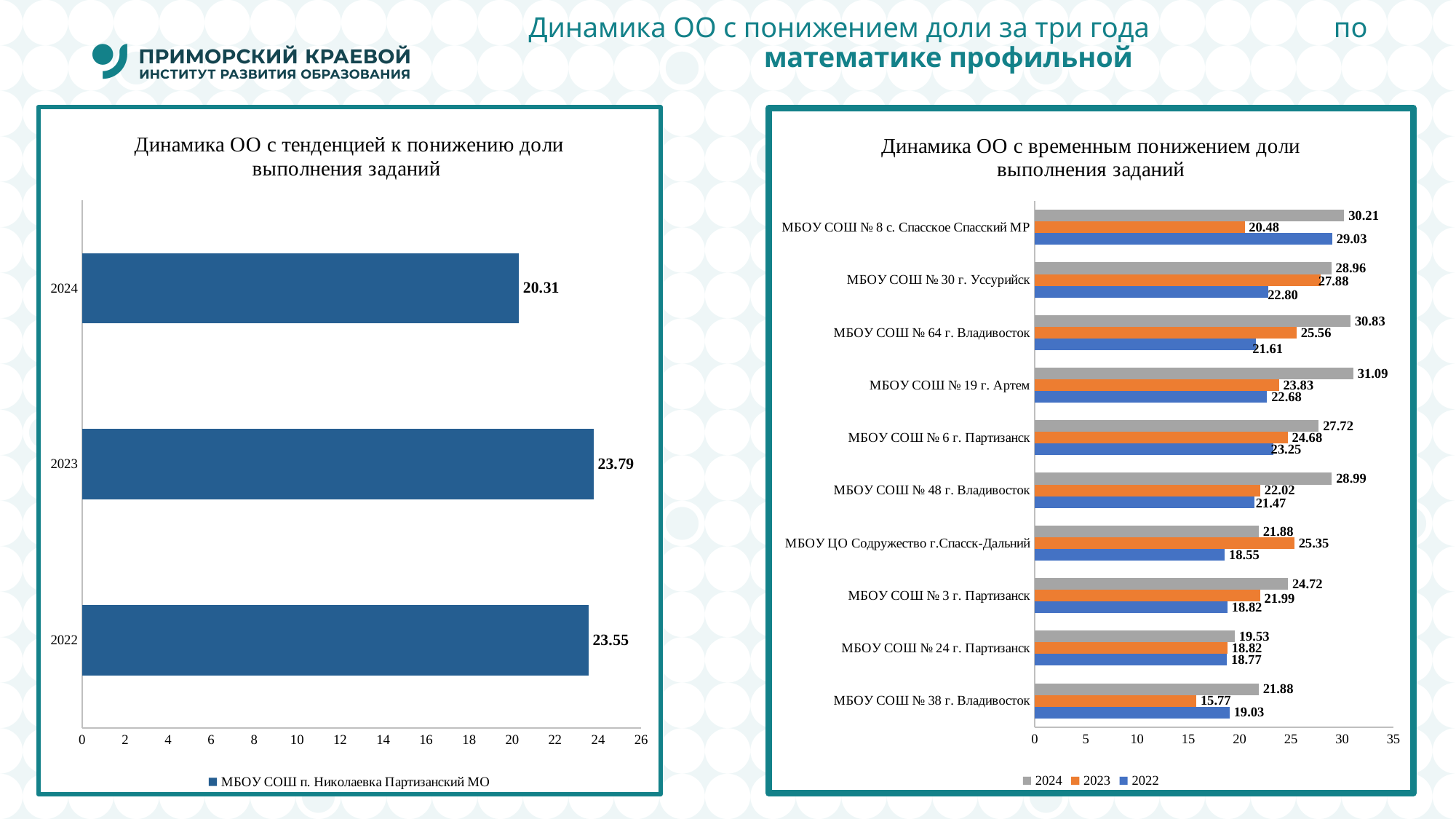
In the right chart 'Динамика ОО с временным понижением доли выполнения заданий', how many schools are shown? 10 In the right chart 'Динамика ОО с временным понижением доли выполнения заданий', what is the 2022 value for МБОУ СОШ № 38 г. Владивосток? 19.03 In the right chart 'Динамика ОО с временным понижением доли выполнения заданий', which school has the highest 2024 value? МБОУ СОШ № 19 г. Артем In the right chart 'Динамика ОО с временным понижением доли выполнения заданий', which is larger for МБОУ ЦО Содружество г.Спасск-Дальний: the 2023 value or the 2024 value? 2023 In the left chart 'Динамика ОО с тенденцией к понижению доли выполнения заданий', which year has the highest value? 2023 In the right chart 'Динамика ОО с временным понижением доли выполнения заданий', how many series does the legend list? 3 In the right chart 'Динамика ОО с временным понижением доли выполнения заданий', which school has the lowest 2023 value? МБОУ СОШ № 38 г. Владивосток What kind of chart is the right chart 'Динамика ОО с временным понижением доли выполнения заданий'? Bar chart In the left chart 'Динамика ОО с тенденцией к понижению доли выполнения заданий', what is the difference between the 2023 and 2024 values? 3.48 In the left chart 'Динамика ОО с тенденцией к понижению доли выполнения заданий', what is the value for 2024? 20.31 In the left chart 'Динамика ОО с тенденцией к понижению доли выполнения заданий', which school does the legend name? МБОУ СОШ п. Николаевка Партизанский МО In the right chart 'Динамика ОО с временным понижением доли выполнения заданий', what is the 2023 value for МБОУ СОШ № 8 с. Спасское Спасский МР? 20.48